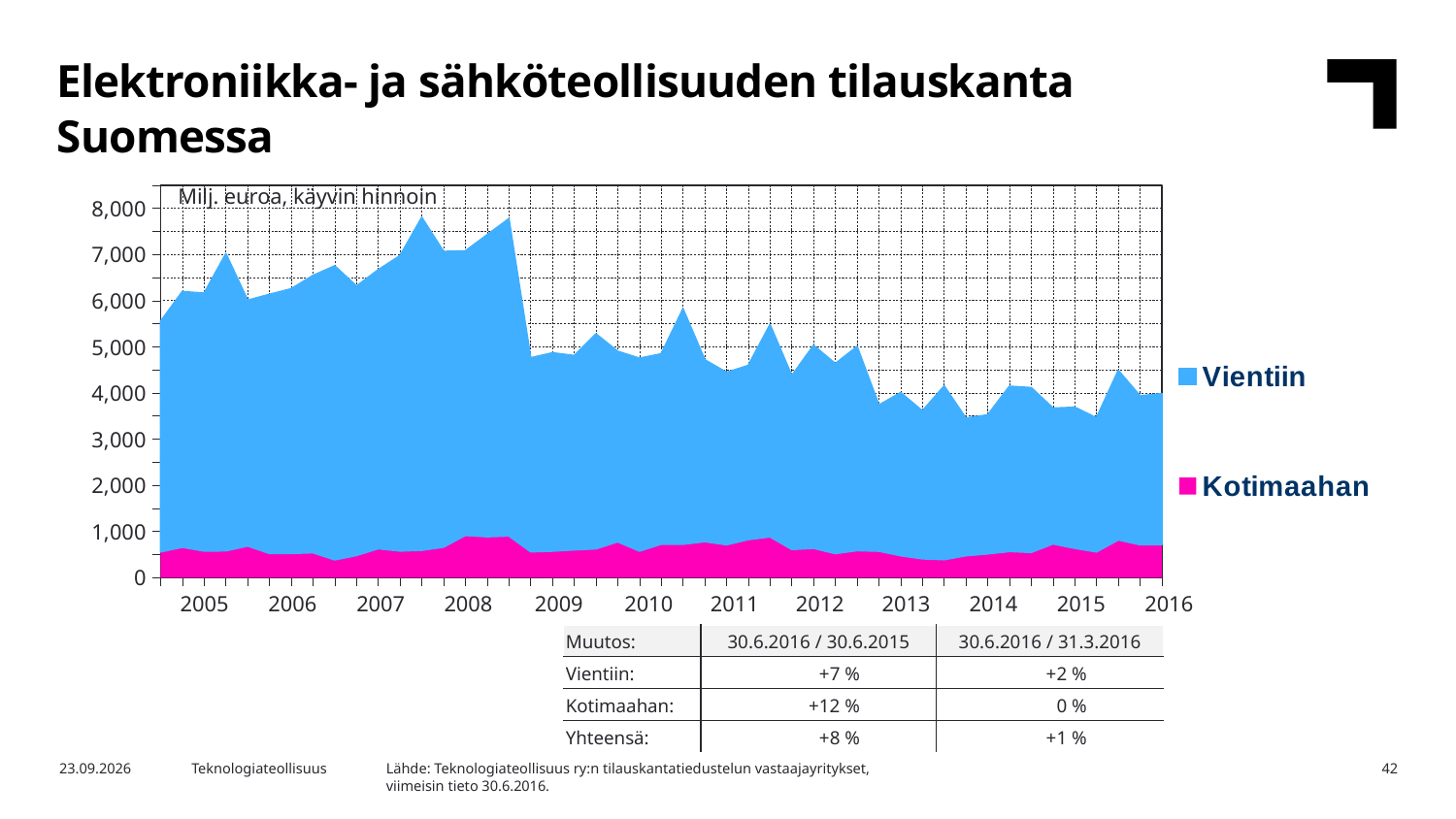
How many series does the legend list? 2 What unit label is shown at the top of the chart? Milj. euroa, käyvin hinnoin What are the two series named in the legend? Vientiin and Kotimaahan Which series is larger throughout the chart, Vientiin or Kotimaahan? Vientiin Is the total order backlog at the start of 2005 greater or less than 5,000? greater Is the total order backlog in 2007 greater or less than 6,000? greater How many years are labelled on the x axis? 12 Is the total order backlog in 2014 greater or less than 5,000? less What kind of chart is shown on the slide? area chart What is the highest value shown on the y axis? 8,000 Does the total order backlog rise or fall between 2008 and 2016? fall